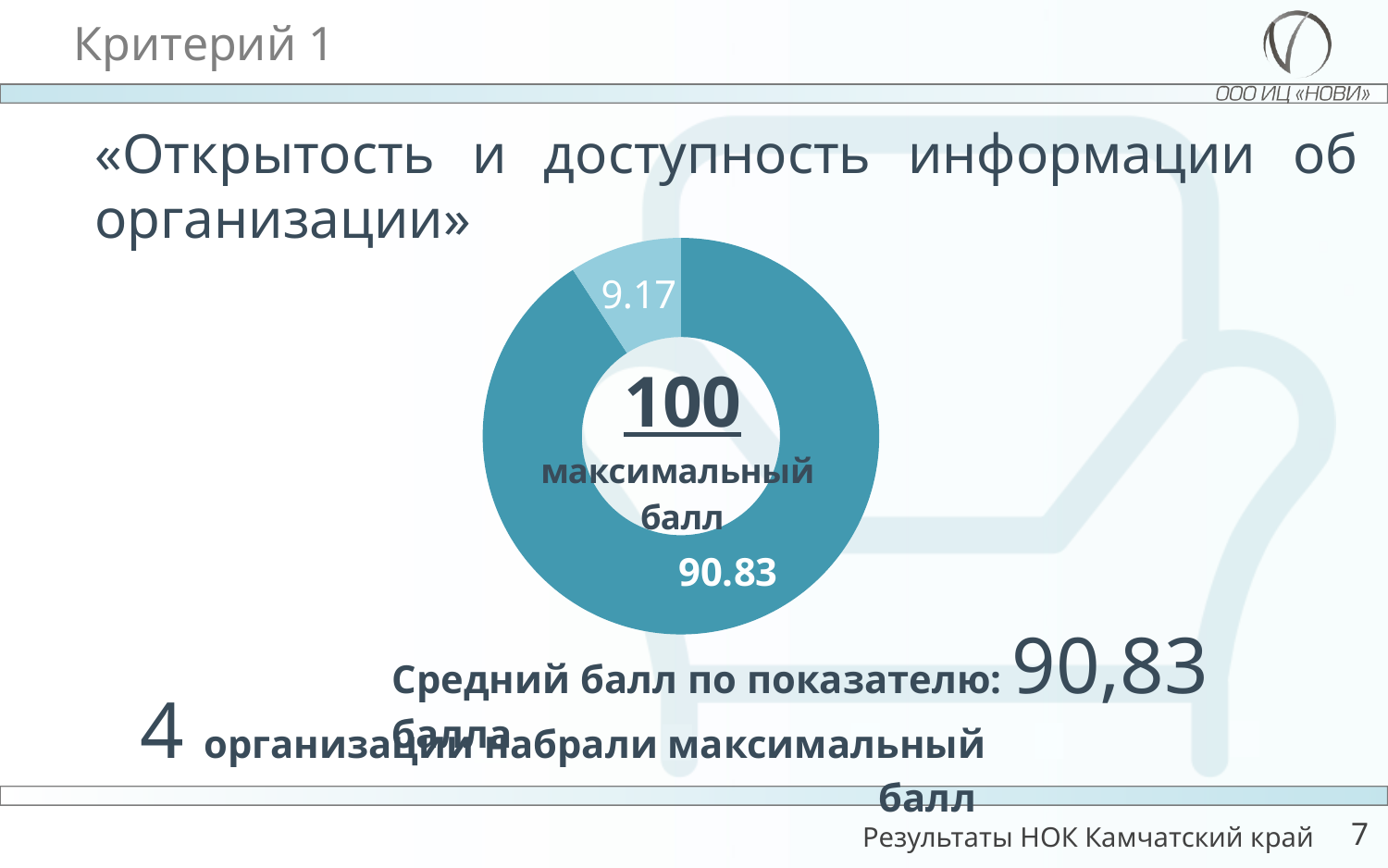
Is the slice labelled 90.83 larger or smaller than the slice labelled 9.17? Larger What value is labelled on the larger, dark teal slice of the donut chart? 90.83 Which slice of the donut chart is the largest, the dark teal one or the light teal one? The dark teal one (90.83) How many slices does the donut chart have? 2 What kind of chart is shown on the slide? Pie (donut) chart What is the difference between the two slice values in the donut chart (90.83 and 9.17)? 81.66 What is the total of the two slice values shown in the donut chart? 100 What text accompanies the number in the centre of the donut chart? максимальный балл What number is written in the centre of the donut chart? 100 What share of the whole donut does the slice labelled 90.83 represent? 90.83% Which slice of the donut chart is the smallest? The light teal one (9.17) What value is labelled on the smaller, light teal slice of the donut chart? 9.17